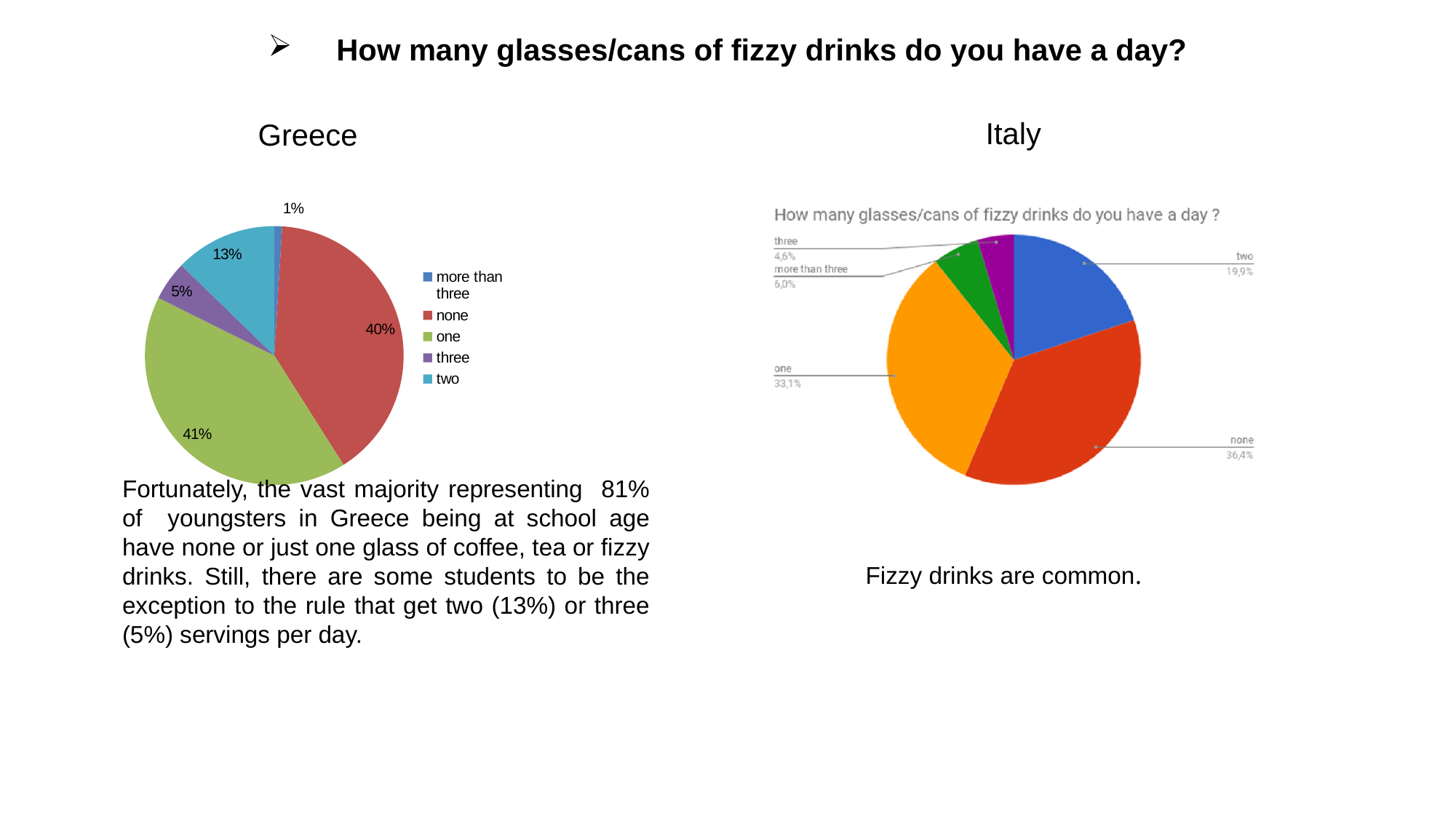
In the Greece pie chart, how many categories does the legend list? 5 In the Greece pie chart, what is the difference between the share for two and the share for three? 8% In the Greece pie chart, which category has the smallest share? more than three In the Italy pie chart, what is the difference between the share for none and the share for two? 16,5% In the Italy pie chart, which is larger, the share for two or the share for three? two In the Greece pie chart, what colour is the slice for one? green In the Greece pie chart, what percentage of respondents have none? 40% In the Italy pie chart, what percentage of respondents have more than three? 6,0% What type of chart is used for Greece? pie chart In the Greece pie chart, what percentage of respondents have two glasses/cans a day? 13% In the Italy pie chart, what percentage of respondents have one glass/can a day? 33,1% In the Italy pie chart, what percentage of respondents have none? 36,4%